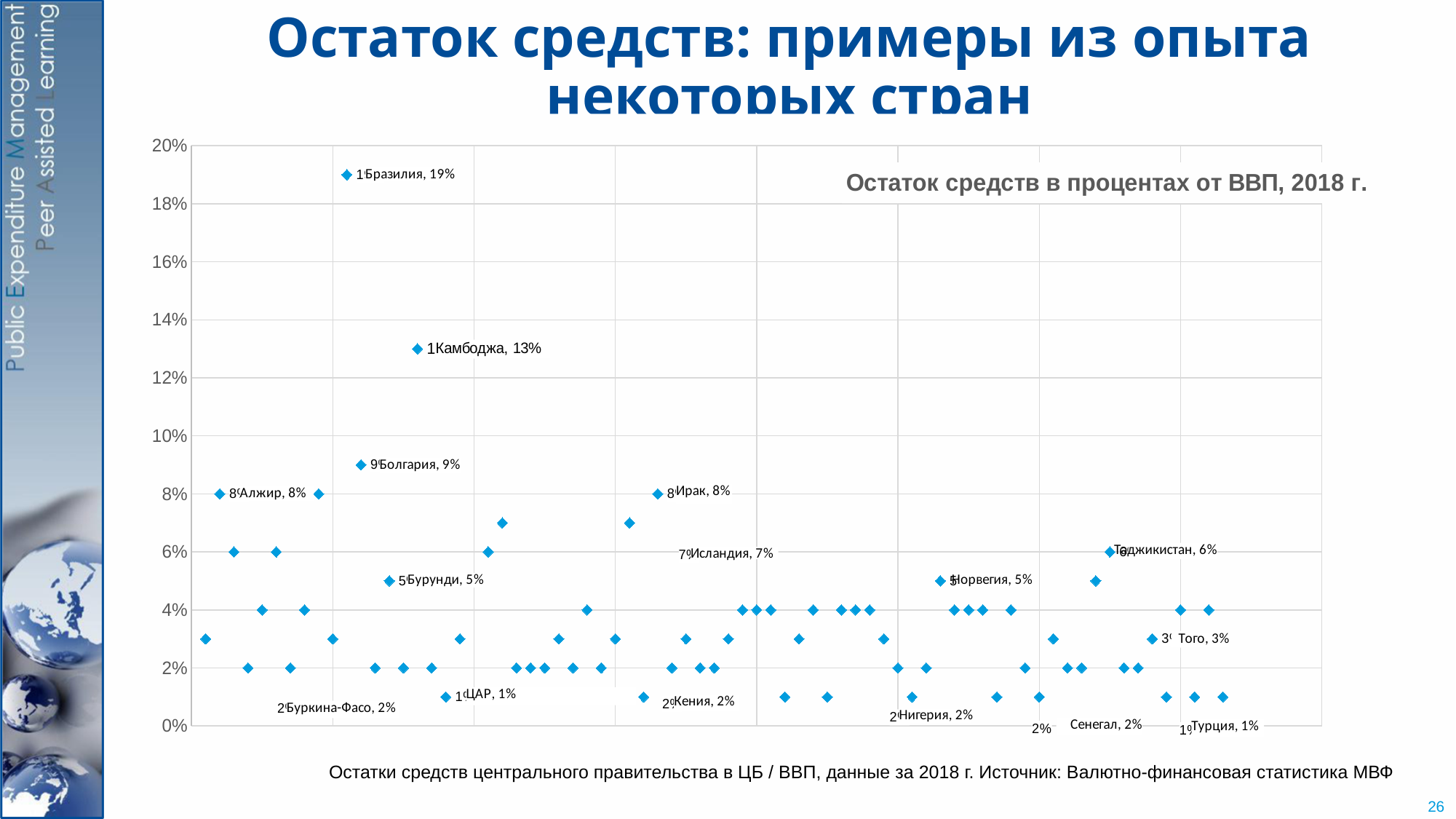
What is the value shown for Таджикистан? 6% What kind of chart is shown on the slide? Scatter chart Which labelled country has the highest value on the chart? Бразилия What is the value shown for Болгария? 9% What is the title of the chart? Остаток средств в процентах от ВВП, 2018 г. What is the difference between the values for Бразилия and Камбоджа? 6 percentage points What is the value shown for Камбоджа? 13% Is the value for Бразилия greater or less than 18%? greater Which has a larger value, Ирак or Того? Ирак What is the value shown for Норвегия? 5% What is the value shown for Бразилия? 19% Which has a larger value, Болгария or Бурунди? Болгария